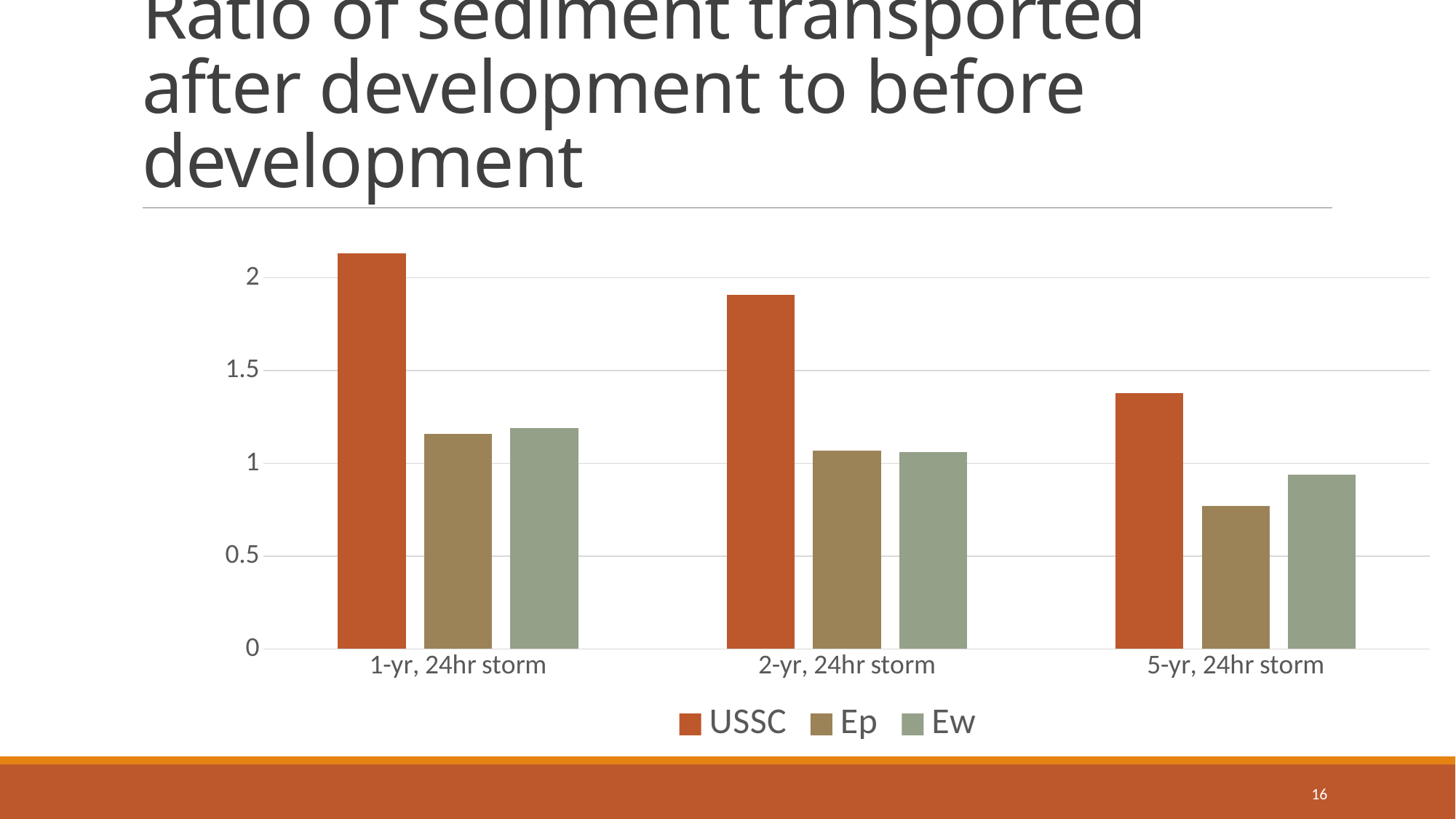
For the 5-yr, 24hr storm, which is larger, the Ew value or the Ep value? Ew For the 2-yr, 24hr storm, which is larger, the USSC value or the Ep value? USSC What kind of chart is shown on the slide? bar chart Is the USSC value for the 2-yr, 24hr storm greater or less than 1.5? greater Which storm category has the highest USSC value? 1-yr, 24hr storm Which storm category has the lowest Ep value? 5-yr, 24hr storm Is the Ep value for the 5-yr, 24hr storm greater or less than 1? less How many series does the legend list? 3 Is the USSC value for the 5-yr, 24hr storm greater or less than 1.5? less Do the USSC values rise or fall from the 1-yr storm to the 5-yr storm? fall How many storm categories are shown on the x axis? 3